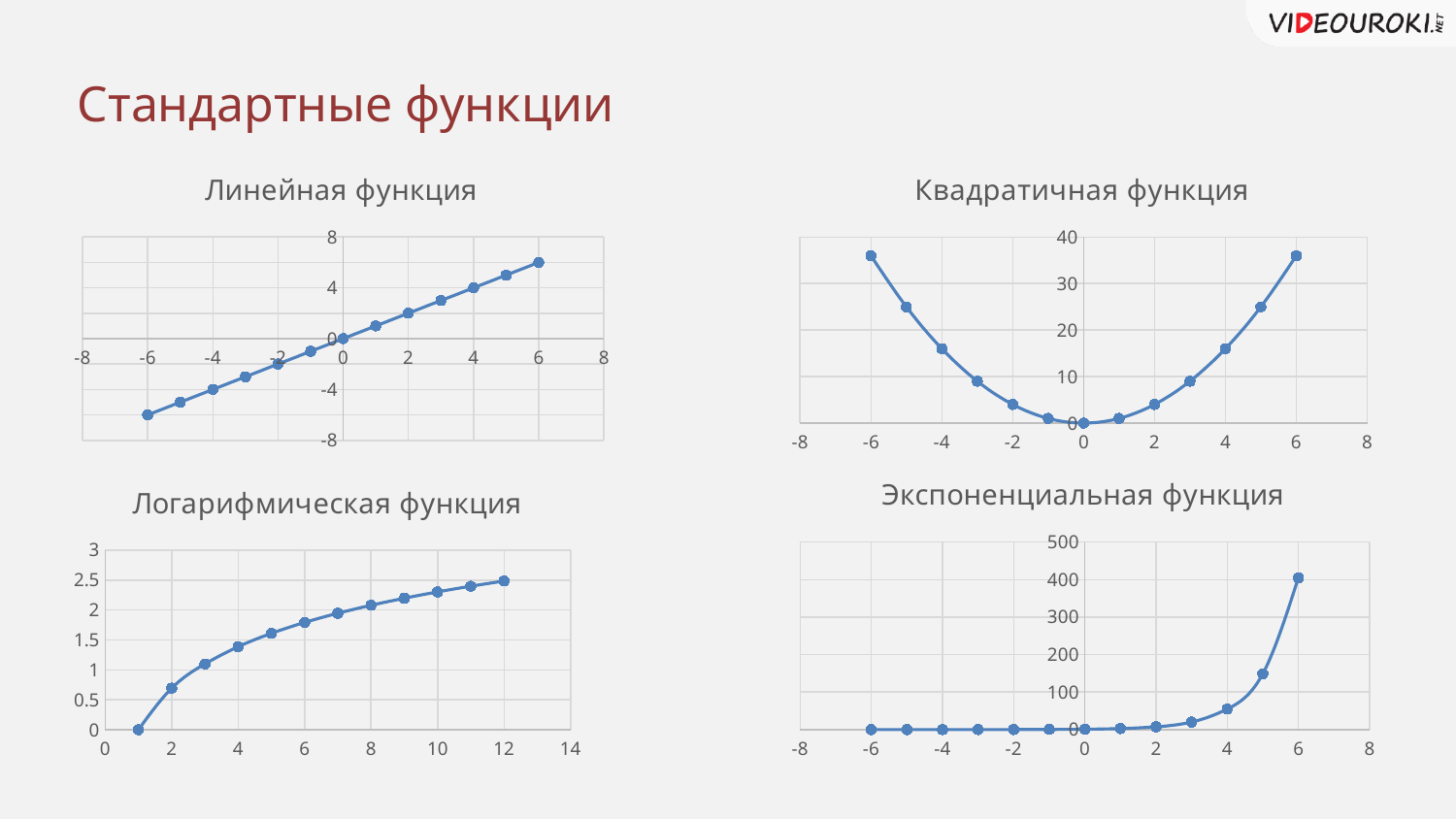
What kind of chart is the chart titled 'Экспоненциальная функция'? line chart In the chart titled 'Линейная функция', how many data points are plotted? 13 In the chart titled 'Линейная функция', do the values rise or fall as x increases? rise How many charts are on the slide? 4 In the chart titled 'Логарифмическая функция', is the value at x = 12 greater or less than 2? greater In the chart titled 'Квадратичная функция', is the value at x = 6 greater or less than 30? greater In the chart titled 'Логарифмическая функция', how many data points are plotted? 12 In the chart titled 'Квадратичная функция', is the value at x = -4 greater or less than 20? less In the chart titled 'Линейная функция', what is the y value of the point at x = 4? 4 In the chart titled 'Квадратичная функция', at which x value is the plotted value lowest? 0 What is the title of the chart in the top-left of the slide? Линейная функция